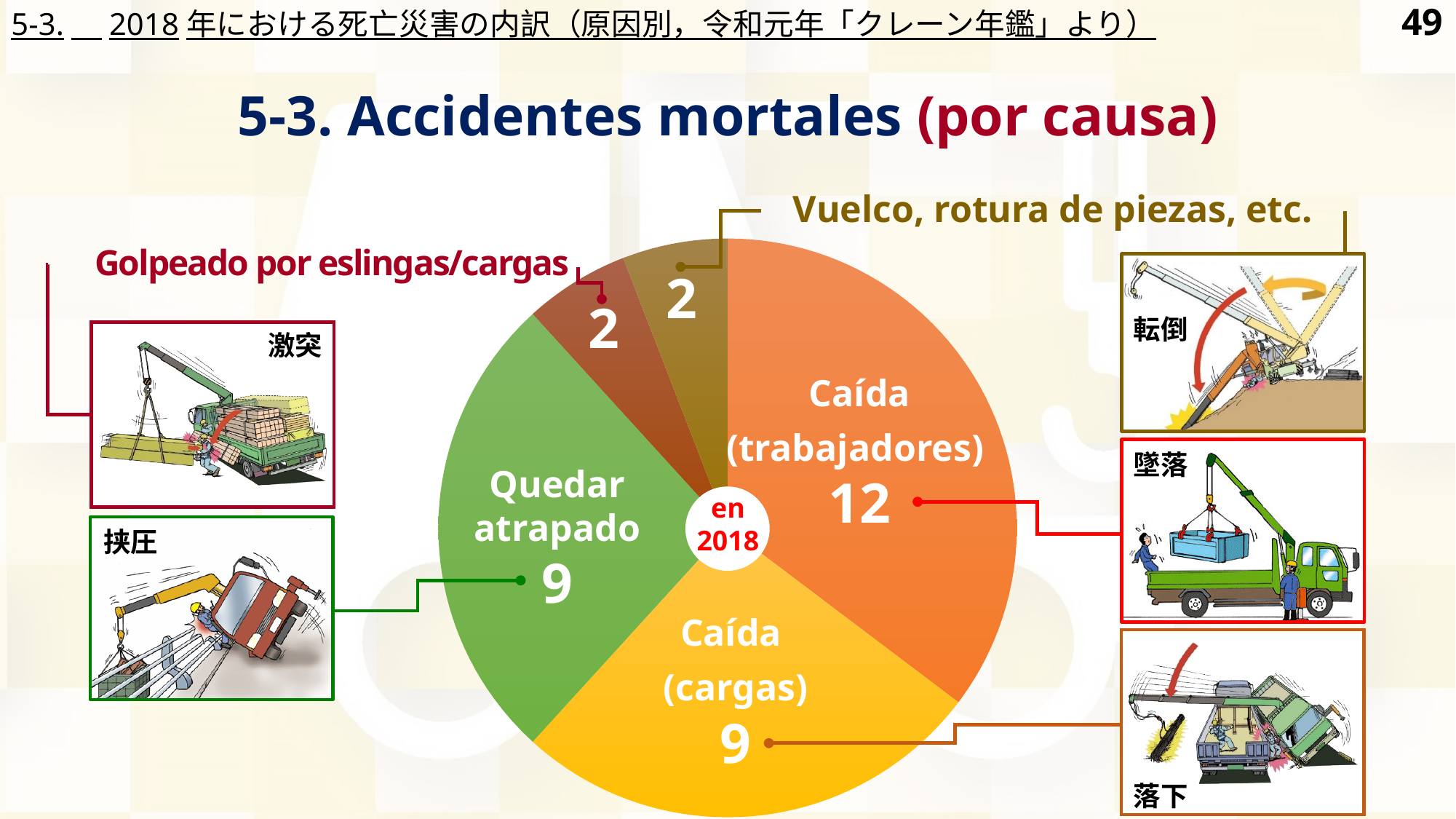
What is the difference between Caída (trabajadores) and Caída (cargas)? 3 Which cause has the highest value in the pie chart? Caída (trabajadores) What text is written in the centre of the pie chart? en 2018 Which is larger, Caída (trabajadores) or Quedar atrapado? Caída (trabajadores) What is the value for Caída (cargas)? 9 What is the sum of all the values in the pie chart? 34 What is the value for Golpeado por eslingas/cargas? 2 What is the value for Quedar atrapado? 9 What kind of chart is shown on the slide? pie chart What is the value for Vuelco, rotura de piezas, etc.? 2 What is the value for Caída (trabajadores)? 12 How many slices does the pie chart have? 5